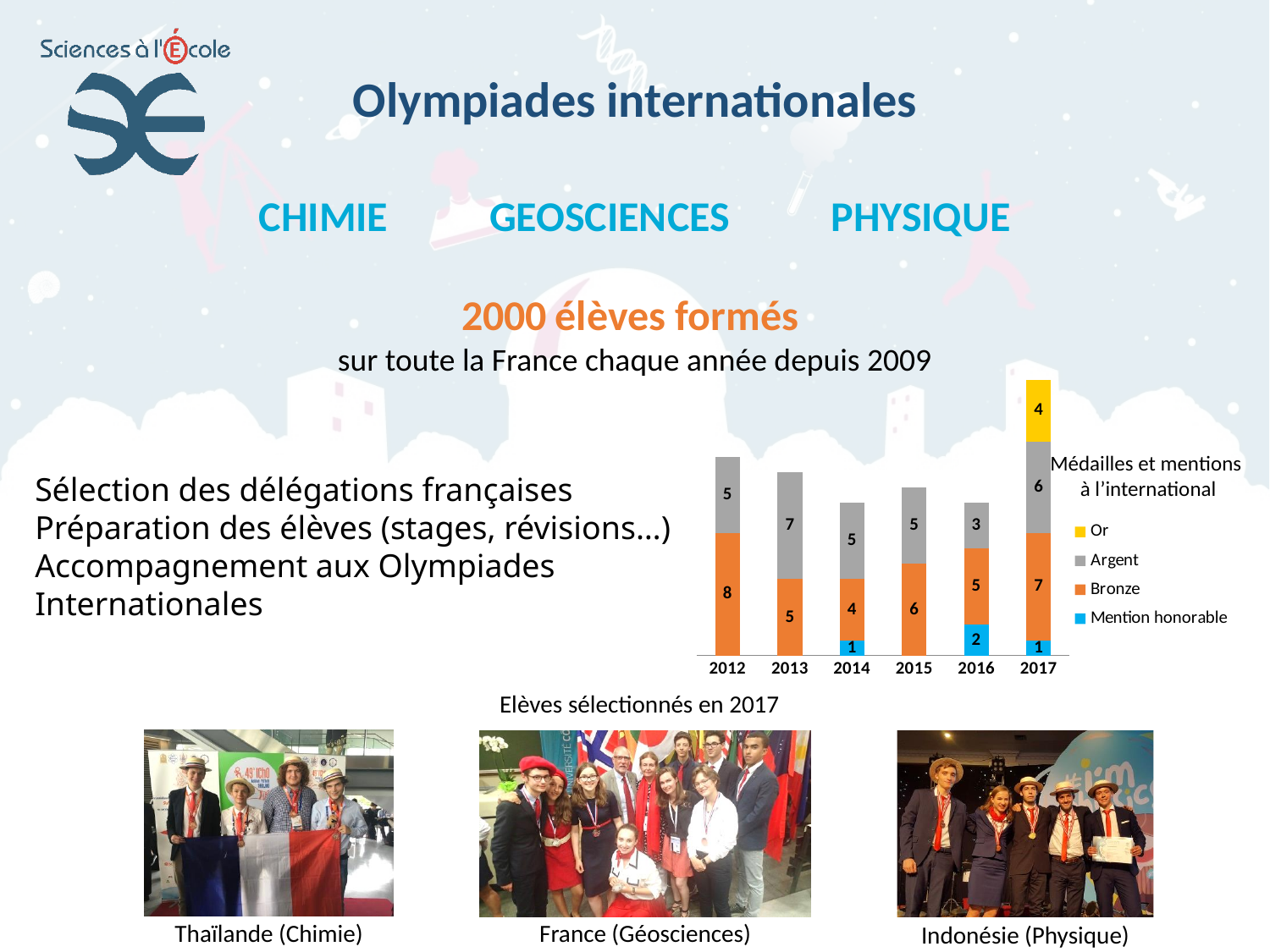
Which year has the highest total of medals and mentions? 2017 What is the Or value for 2017? 4 What is the Argent value for 2013? 7 What is the total of the stacked bar for 2014? 10 How many years are shown on the x axis of the chart? 6 What is the Mention honorable value for 2016? 2 What is the title of the chart? Médailles et mentions à l'international What kind of chart is shown on the slide? Stacked bar chart What is the Bronze value for 2012? 8 What is the total of the stacked bar for 2017? 18 What is the difference between the Bronze values for 2012 and 2013? 3 How many series does the chart legend list? 4